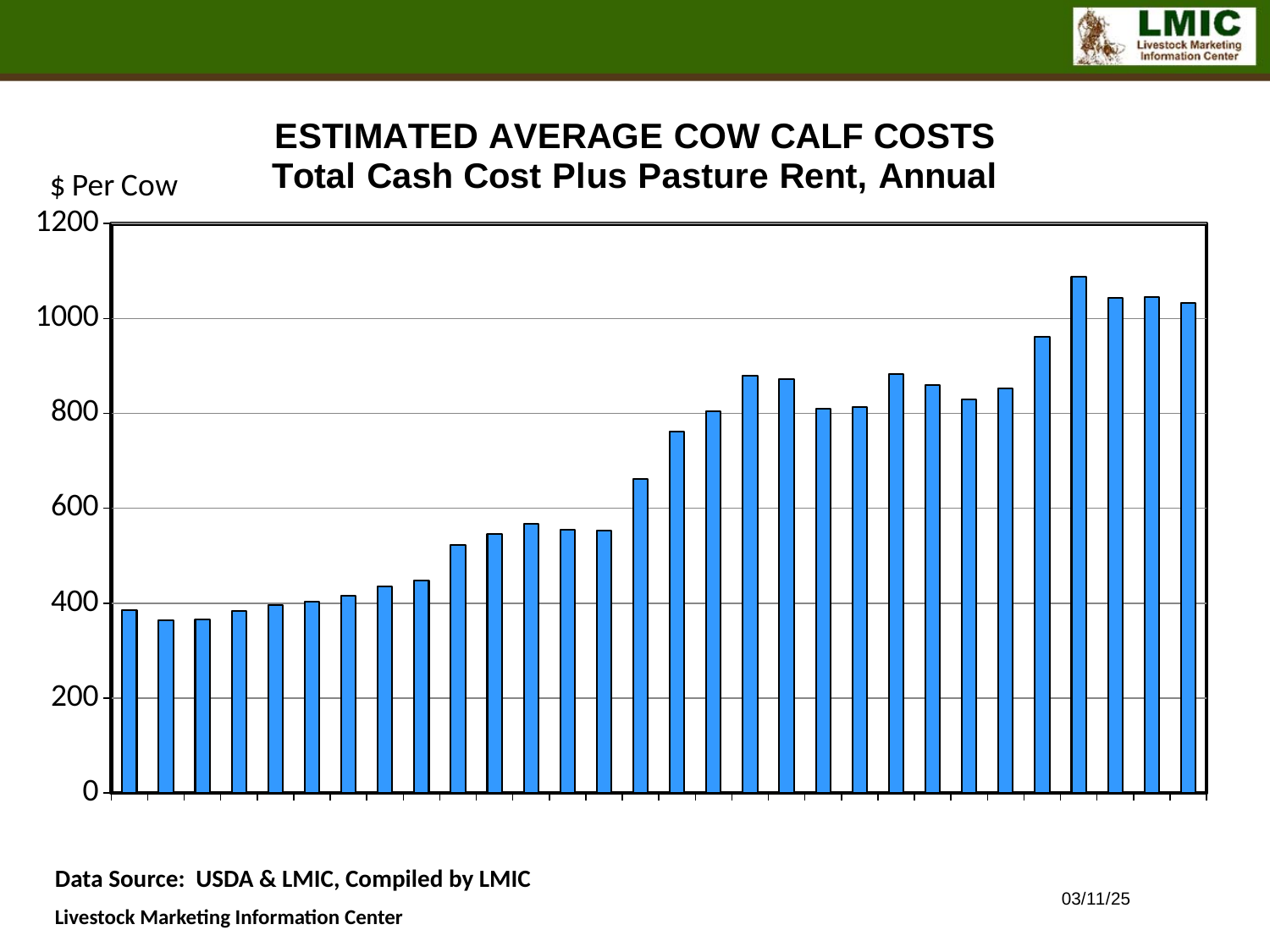
What is the title of the chart? ESTIMATED AVERAGE COW CALF COSTS Total Cash Cost Plus Pasture Rent, Annual What is the label on the vertical axis of the chart? $ Per Cow Is the value of the tallest bar greater or less than 1000? greater Do the values generally rise or fall from left to right across the chart? Rise What kind of chart is shown on the slide? Bar chart Is the value of the first (leftmost) bar greater or less than 600? less How many bars are plotted in the chart? 30 Is the value of the last (rightmost) bar greater or less than 800? greater Which is larger, the first bar or the last bar? The last bar What is the highest value shown on the vertical axis? 1200 Is the tallest bar located on the left side or the right side of the chart? Right side